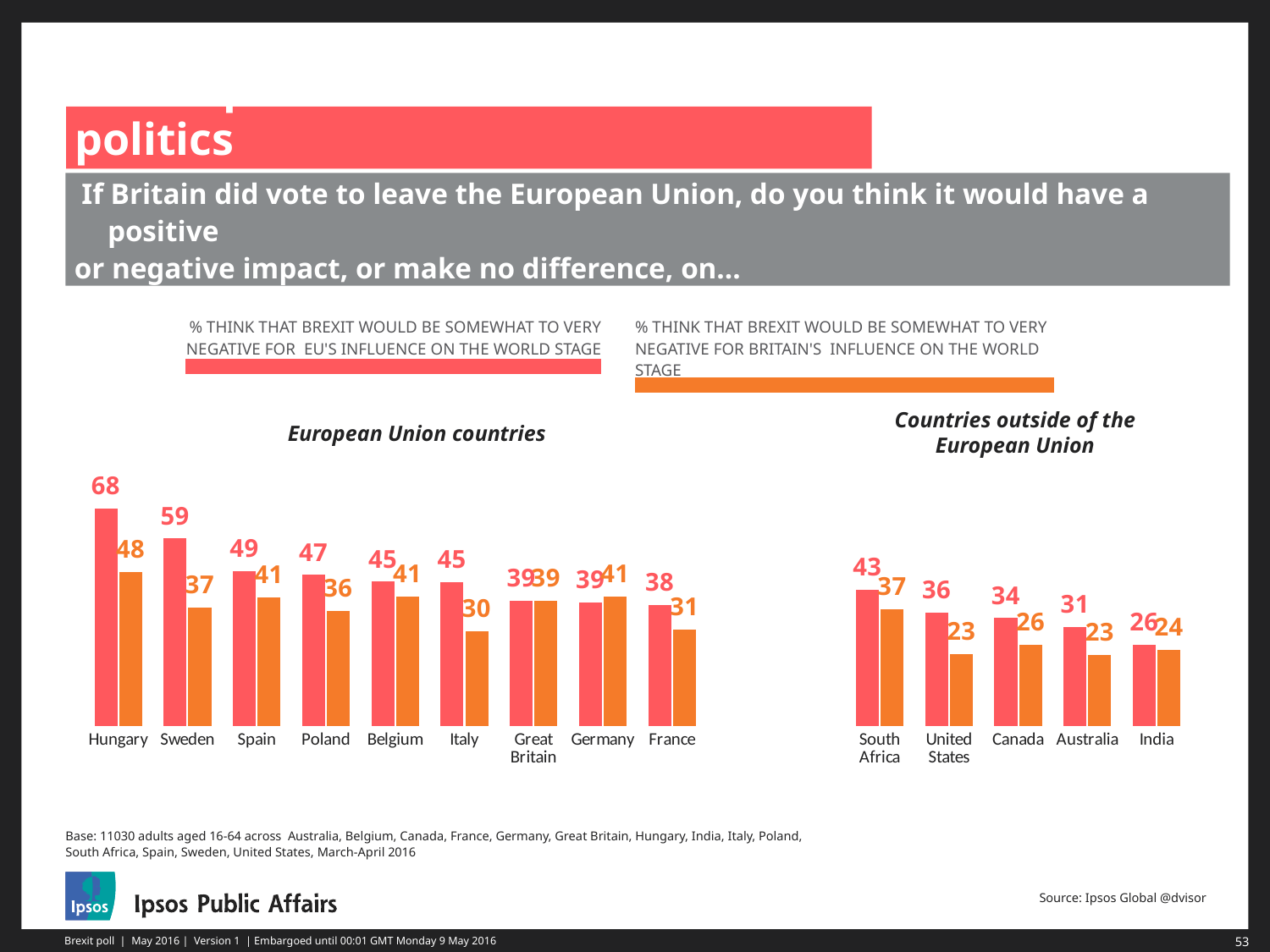
In the 'Countries outside of the European Union' chart, what is the difference between the red bar for South Africa and the red bar for Canada? 9 What type of chart is used for the 'Countries outside of the European Union' data? Bar chart In the 'European Union countries' chart, what is the difference between the two values shown for Sweden? 22 How many countries are shown in the 'Countries outside of the European Union' chart? 5 In the 'European Union countries' chart, which country has the highest value for EU's influence on the world stage (red bar)? Hungary In the 'European Union countries' chart, what percentage of people in Hungary think Brexit would be negative for the EU's influence on the world stage? 68 How many countries are shown in the 'European Union countries' chart? 9 In the 'European Union countries' chart, which is larger for Germany: the value for EU's influence (red) or the value for Britain's influence (orange)? Britain's influence (orange), 41 In the 'European Union countries' chart, do the red bar values generally rise or fall from Hungary to France? Fall In the 'Countries outside of the European Union' chart, which country has the lowest value for EU's influence on the world stage (red bar)? India In the 'European Union countries' chart, what is the value for Italy for Britain's influence on the world stage (orange bar)? 30 In the 'Countries outside of the European Union' chart, what is the value for the United States for Britain's influence on the world stage (orange bar)? 23